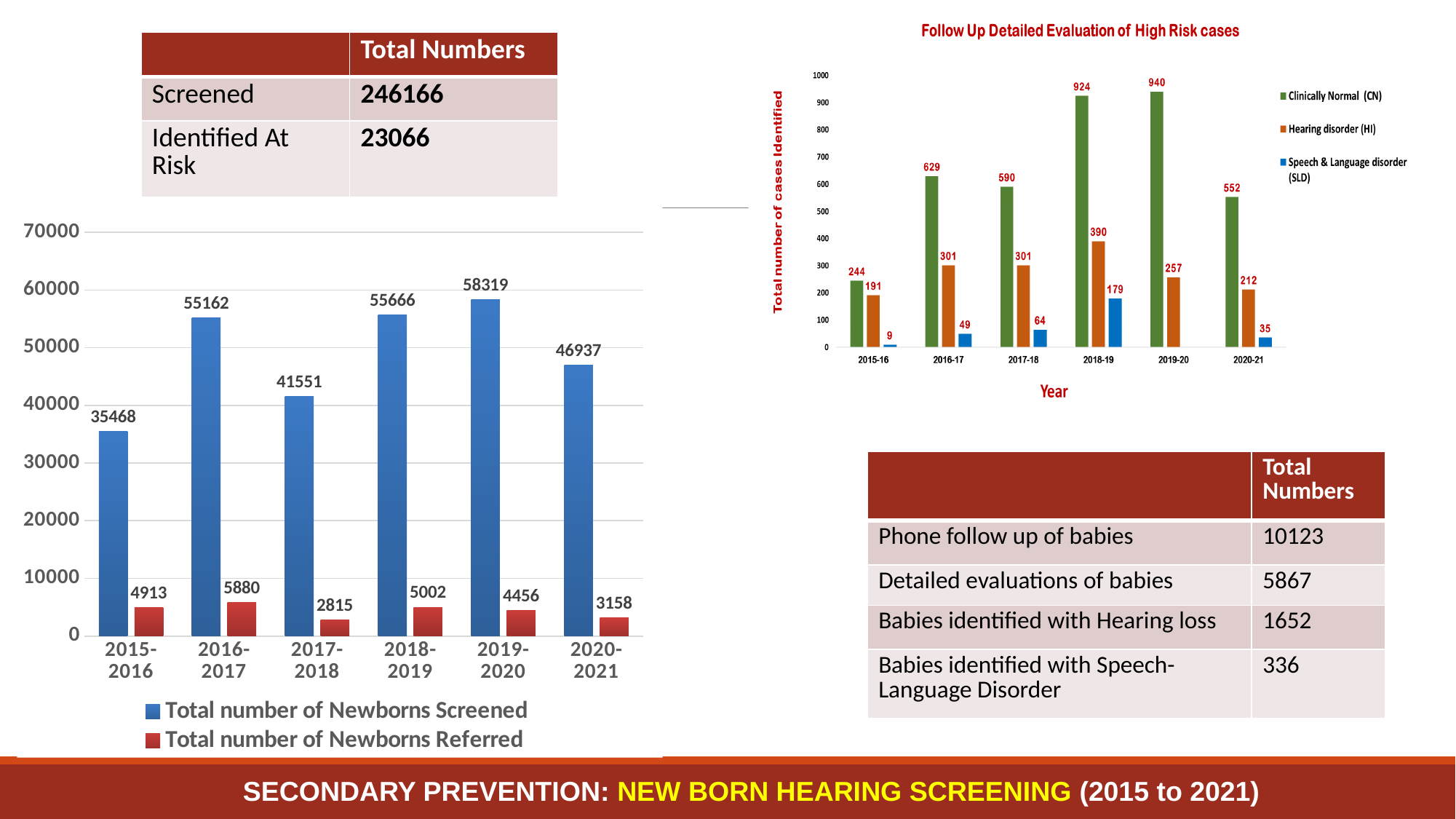
In the chart titled 'Follow Up Detailed Evaluation of High Risk cases', what is the Clinically Normal (CN) value for 2018-19? 924 In the chart titled 'Follow Up Detailed Evaluation of High Risk cases', what is the Speech & Language disorder (SLD) value for 2016-17? 49 In the chart titled 'Follow Up Detailed Evaluation of High Risk cases', is the Clinically Normal (CN) value for 2019-20 larger or the Hearing disorder (HI) value for 2019-20? Clinically Normal (CN) In the left chart, what is the total number of newborns screened in 2019-2020? 58319 In the chart titled 'Follow Up Detailed Evaluation of High Risk cases', which year has the highest Hearing disorder (HI) value? 2018-19 How many years are shown on the x axis of the chart titled 'Follow Up Detailed Evaluation of High Risk cases'? 6 How many series does the legend of the left chart list? 2 In the left chart, which year has the highest number of newborns screened? 2019-2020 In the left chart, what is the difference between newborns screened and newborns referred in 2015-2016? 30555 What kind of chart is the left chart showing newborns screened and referred? Bar chart In the left chart, what is the total number of newborns referred in 2017-2018? 2815 In the left chart, which year has the lowest number of newborns referred? 2017-2018